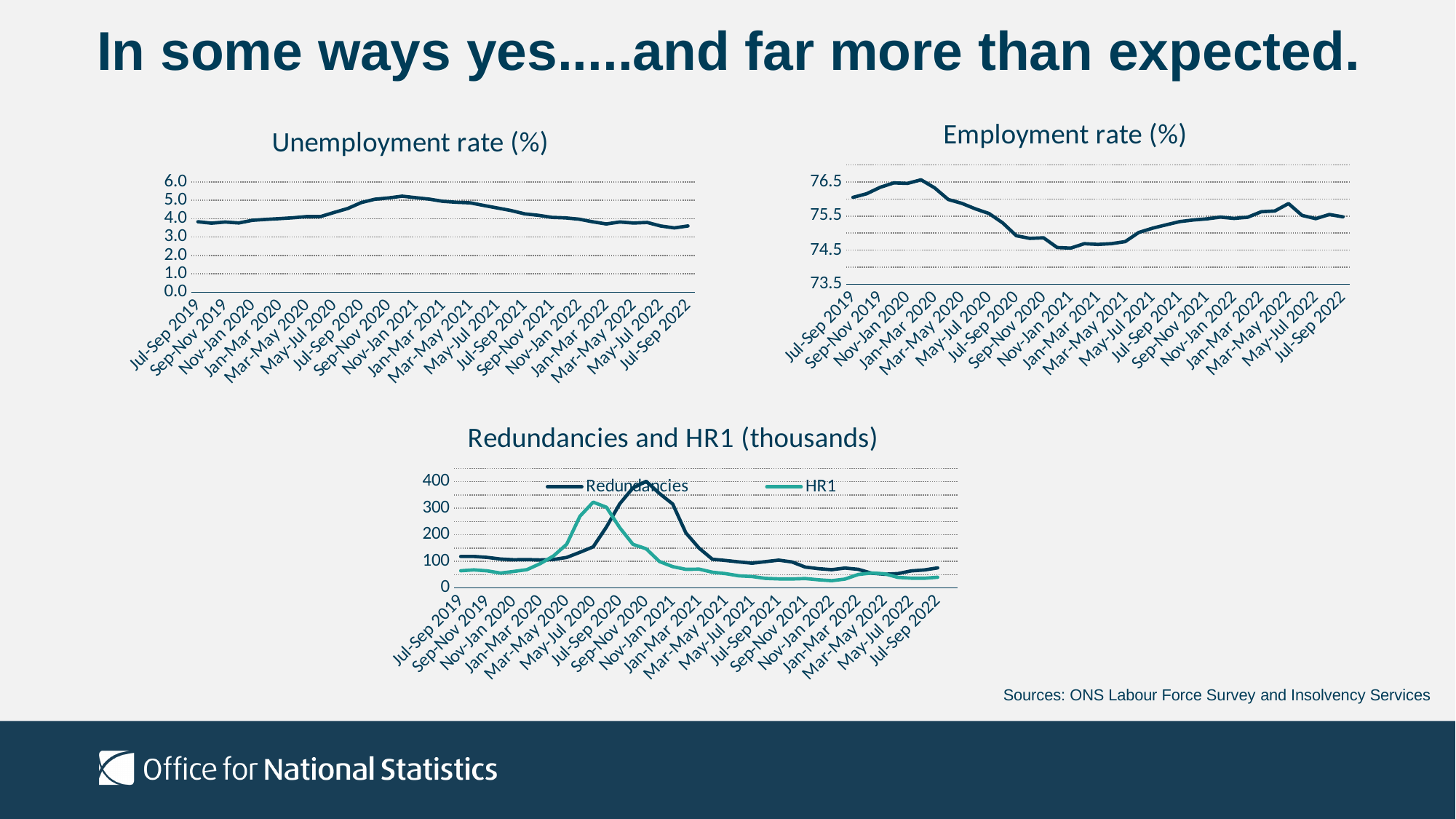
What kind of chart is the 'Unemployment rate (%)' chart? line chart In the 'Redundancies and HR1 (thousands)' chart, which series is shown in the teal/green colour? HR1 In the 'Redundancies and HR1 (thousands)' chart, which series has the larger value at May-Jul 2020, Redundancies or HR1? HR1 In the 'Redundancies and HR1 (thousands)' chart, at which period does the HR1 series reach its highest value? May-Jul 2020 How many series does the legend of the 'Redundancies and HR1 (thousands)' chart list? 2 In the 'Unemployment rate (%)' chart, is the value for Jul-Sep 2022 greater or less than 4.0? less In the 'Employment rate (%)' chart, does the value rise or fall between Jan-Mar 2020 and Jul-Sep 2020? fall In the 'Employment rate (%)' chart, is the value for Jan-Mar 2020 greater or less than 75.5? greater In the 'Redundancies and HR1 (thousands)' chart, is the peak value of the Redundancies series greater or less than 300? greater In the 'Redundancies and HR1 (thousands)' chart, at which period does the Redundancies series reach its highest value? Sep-Nov 2020